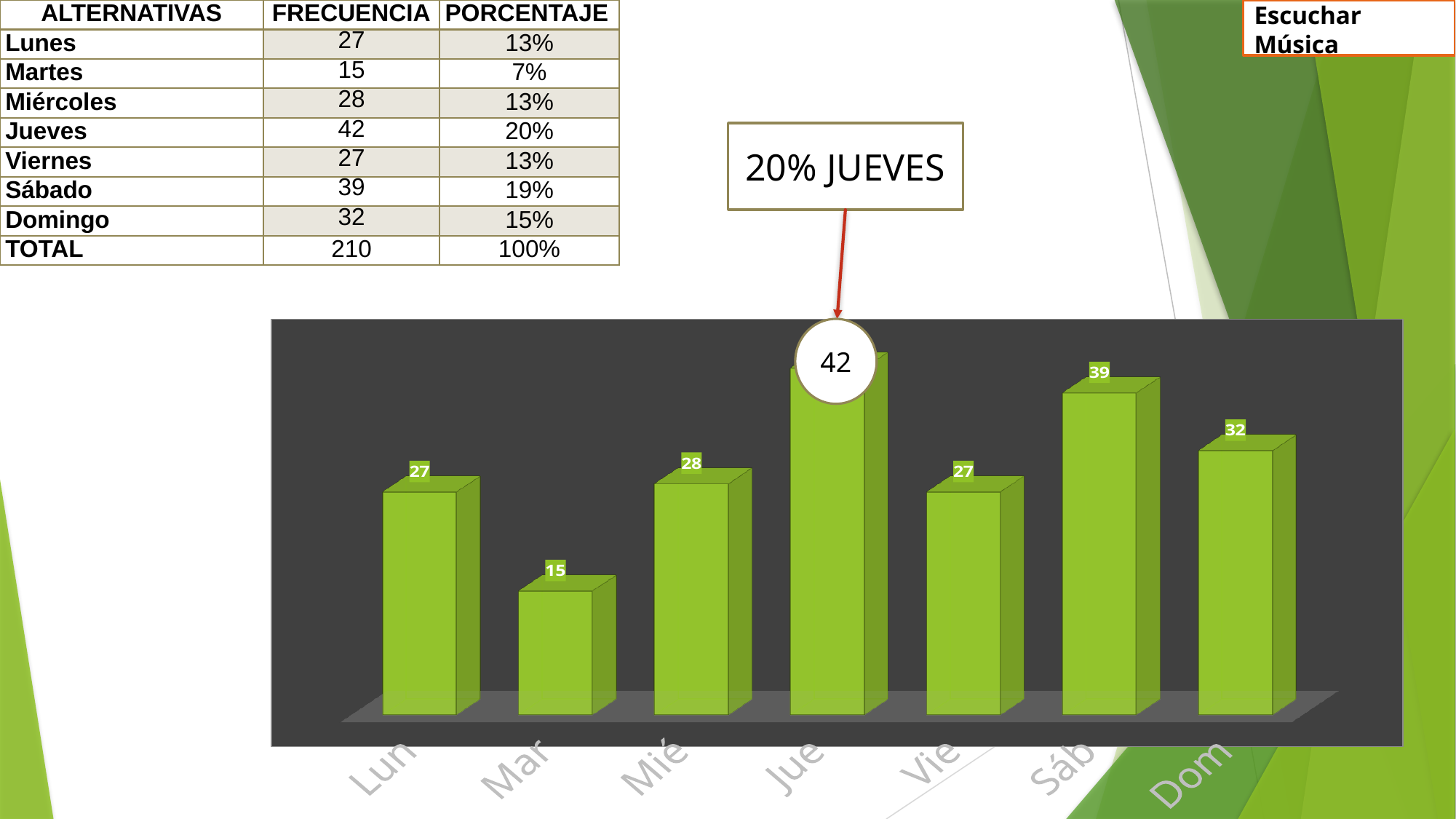
What text is in the callout box pointing to the tallest bar? 20% JUEVES How many bars are shown in the chart? 7 What is the difference between the values for Sáb and Dom? 7 Which category has the lowest bar? Mar What is the value of the bar for Jue? 42 Which is larger, the value for Mié or the value for Vie? Mié What kind of chart is shown on the slide? bar chart What is the value of the bar for Sáb? 39 What is the value of the bar for Mar? 15 What is the value of the bar for Dom? 32 What is the difference between the values for Jue and Mar? 27 Which category has the highest bar? Jue